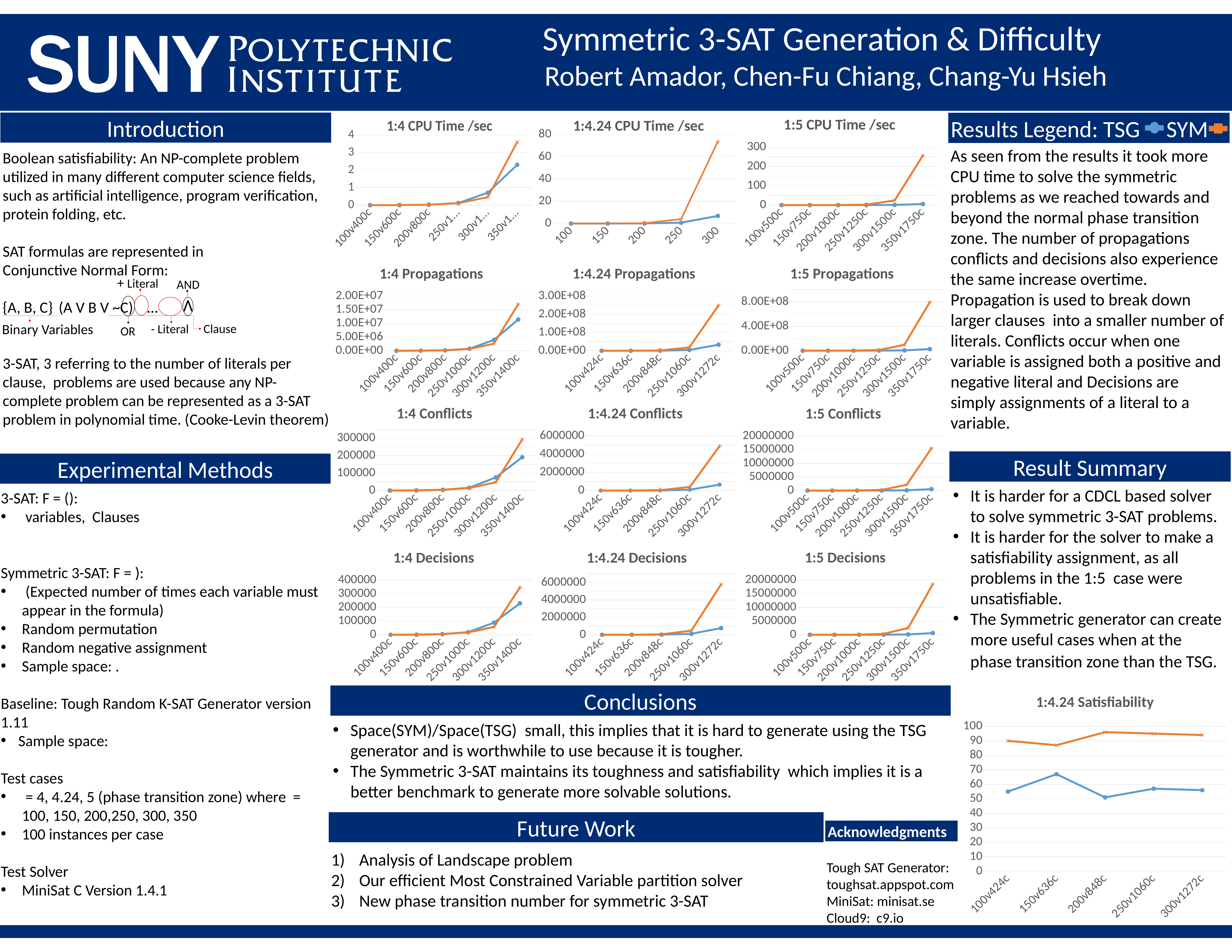
How many series does the Results Legend list for the charts? 2 In the "1:4.24 Satisfiability" chart, is the TSG value at 150v636c greater or less than 60? greater In the "1:4 Decisions" chart, do the values rise or fall as you move along the x axis? rise How many data points are plotted along the x axis of the "1:4.24 Satisfiability" chart? 5 How many categories are shown on the x axis of the "1:5 Conflicts" chart? 6 What kind of chart is the "1:4 CPU Time /sec" chart? line chart According to the Results Legend, which colour represents the SYM series? orange In the "1:4.24 Satisfiability" chart, at which category does the TSG series reach its highest value? 150v636c In the "1:4.24 Satisfiability" chart, which series has the larger value at 200v848c, SYM or TSG? SYM In the "1:4 Conflicts" chart, is the SYM value at 350v1400c greater or less than 200000? greater In the "1:5 CPU Time /sec" chart, is the SYM value at 350v1750c greater or less than 200? greater